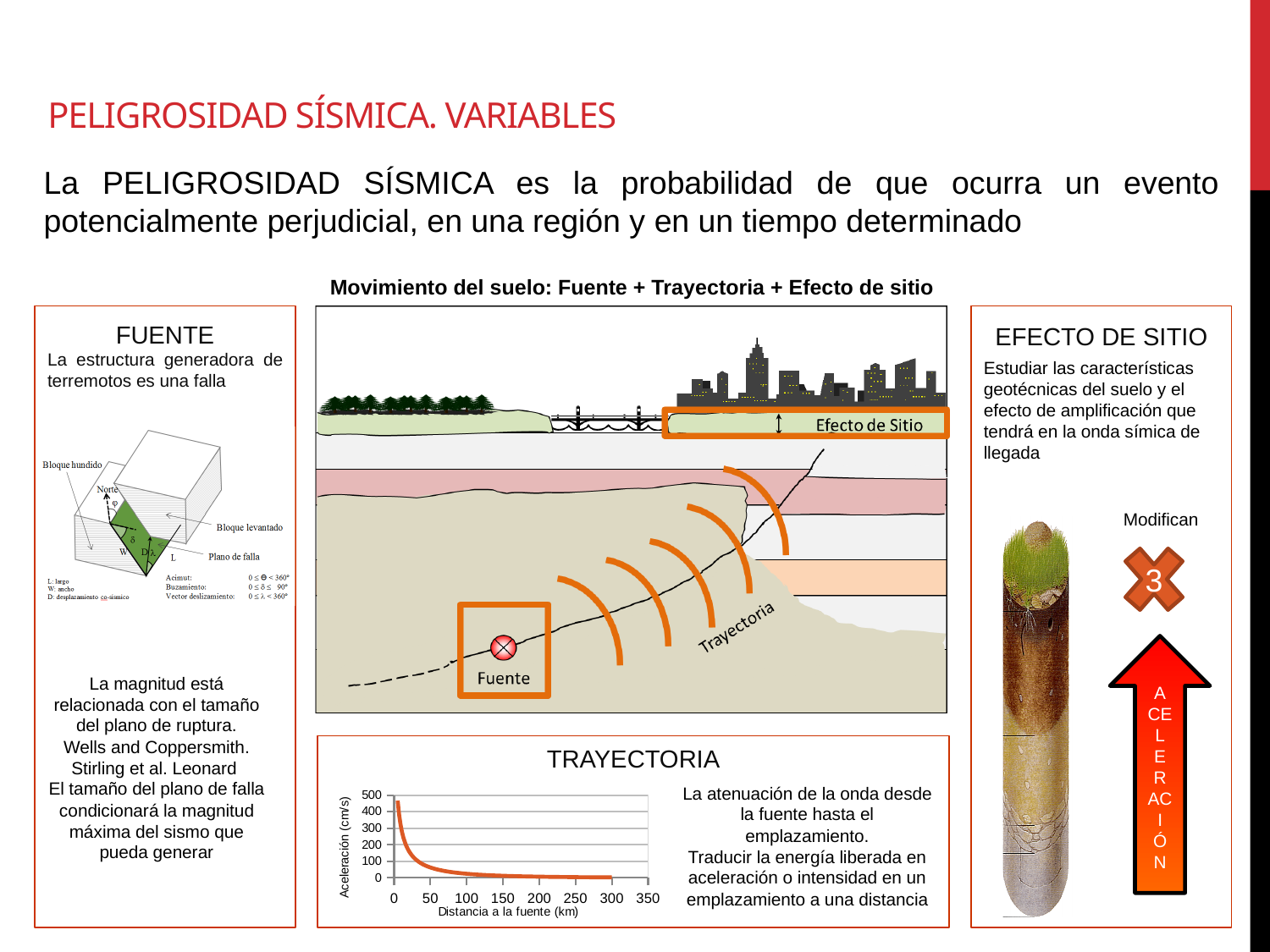
In the TRAYECTORIA chart, is the acceleration at 10 km greater or less than the acceleration at 100 km? greater In the TRAYECTORIA chart, is the acceleration at a distance of 200 km greater or less than 100? less In the TRAYECTORIA chart, is the acceleration at a distance of 50 km greater or less than 100? less What is the label of the x axis of the TRAYECTORIA chart? Distancia a la fuente (km) In the TRAYECTORIA chart, does the acceleration rise or fall as the distance to the source increases? fall What is the highest value shown on the y axis of the TRAYECTORIA chart? 500 In the TRAYECTORIA chart, is the acceleration at a distance of 0 km greater or less than 400? greater What kind of chart is shown in the TRAYECTORIA box? line chart What is the label of the y axis of the TRAYECTORIA chart? Aceleración (cm/s)